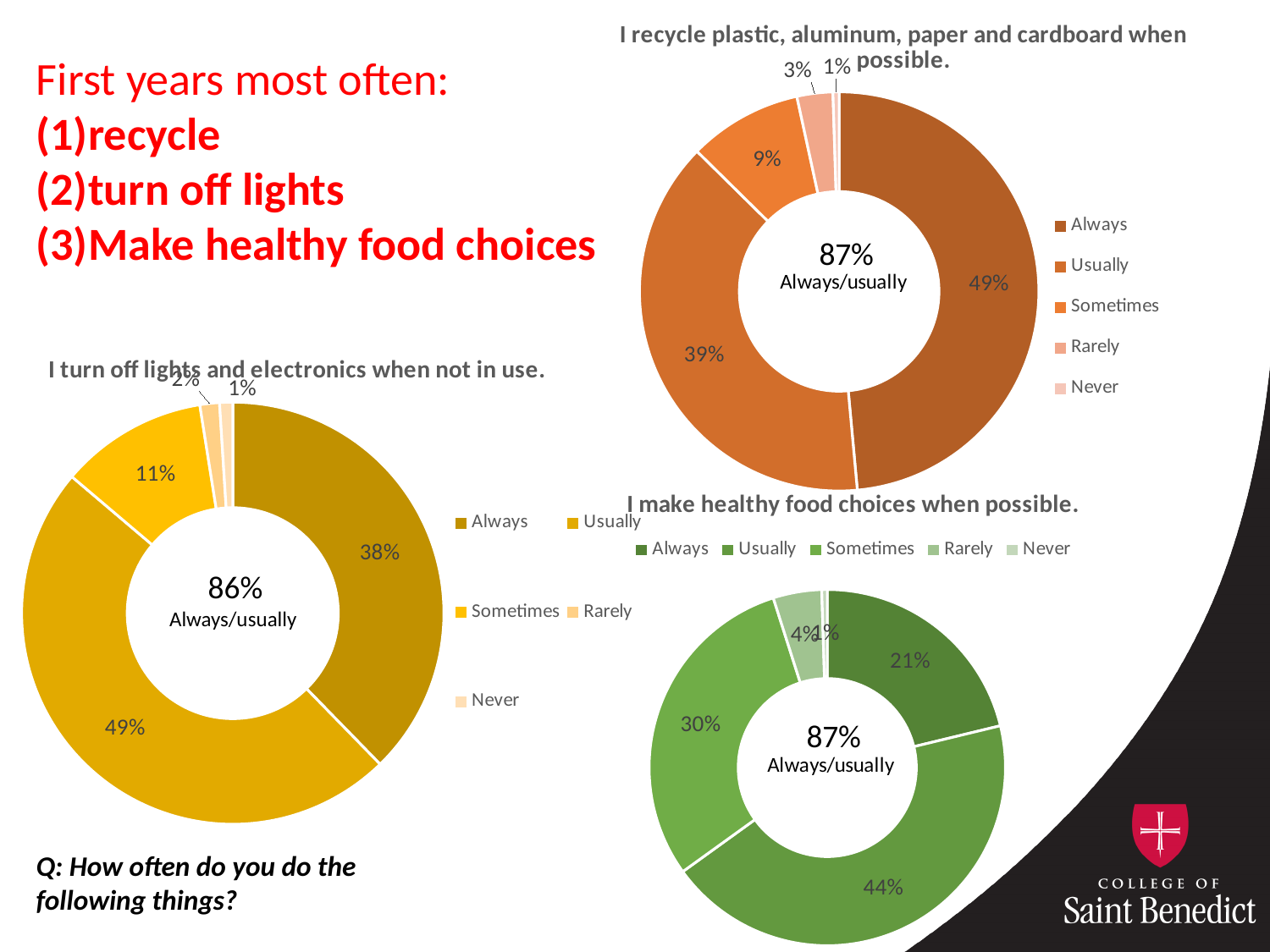
In the chart titled "I make healthy food choices when possible.", what is the difference between the Usually and Always shares? 23% In the chart titled "I turn off lights and electronics when not in use.", what is the difference between the Usually and Always shares? 11% What type of chart is used for "I turn off lights and electronics when not in use."? Doughnut chart In the chart titled "I turn off lights and electronics when not in use.", which response category has the largest share? Usually In the chart titled "I turn off lights and electronics when not in use.", what percentage answered Usually? 49% In the chart titled "I recycle plastic, aluminum, paper and cardboard when possible.", what percentage answered Always? 49% In the chart titled "I make healthy food choices when possible.", which is larger, the Always share or the Sometimes share? Sometimes How many response categories does the legend of the chart titled "I make healthy food choices when possible." list? 5 In the chart titled "I make healthy food choices when possible.", what percentage answered Usually? 44% In the chart titled "I recycle plastic, aluminum, paper and cardboard when possible.", what percentage answered Sometimes? 9% In the chart titled "I recycle plastic, aluminum, paper and cardboard when possible.", which response category has the smallest share? Never What combined Always/usually percentage is shown in the center of the chart titled "I turn off lights and electronics when not in use."? 86%